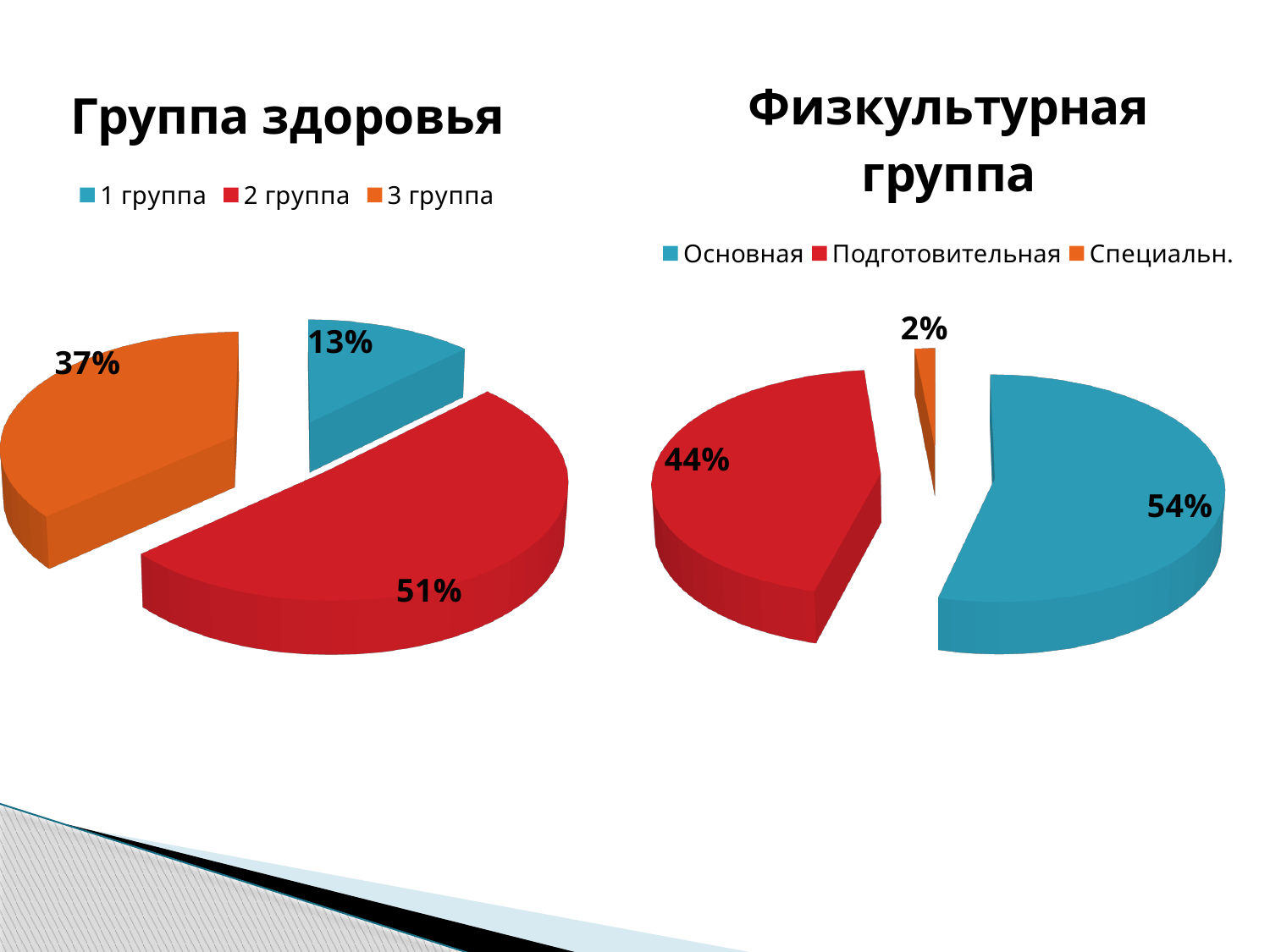
In the "Группа здоровья" chart, what is the value for 1 группа? 13% In the "Физкультурная группа" chart, which is larger, Основная or Подготовительная? Основная In the "Группа здоровья" chart, what is the value for 2 группа? 51% In the "Физкультурная группа" chart, which category has the largest share? Основная In the "Физкультурная группа" chart, what is the difference between Подготовительная and Специальн.? 42% How many entries does the legend of the "Физкультурная группа" chart list? 3 In the "Физкультурная группа" chart, what is the value for Основная? 54% In the "Группа здоровья" chart, which group has the smallest share? 1 группа What type of chart is the "Группа здоровья" chart? Pie chart In the "Группа здоровья" chart, what is the difference between 3 группа and 1 группа? 24% In the "Группа здоровья" chart, which group has the largest share? 2 группа In the "Физкультурная группа" chart, what is the value for Специальн.? 2%